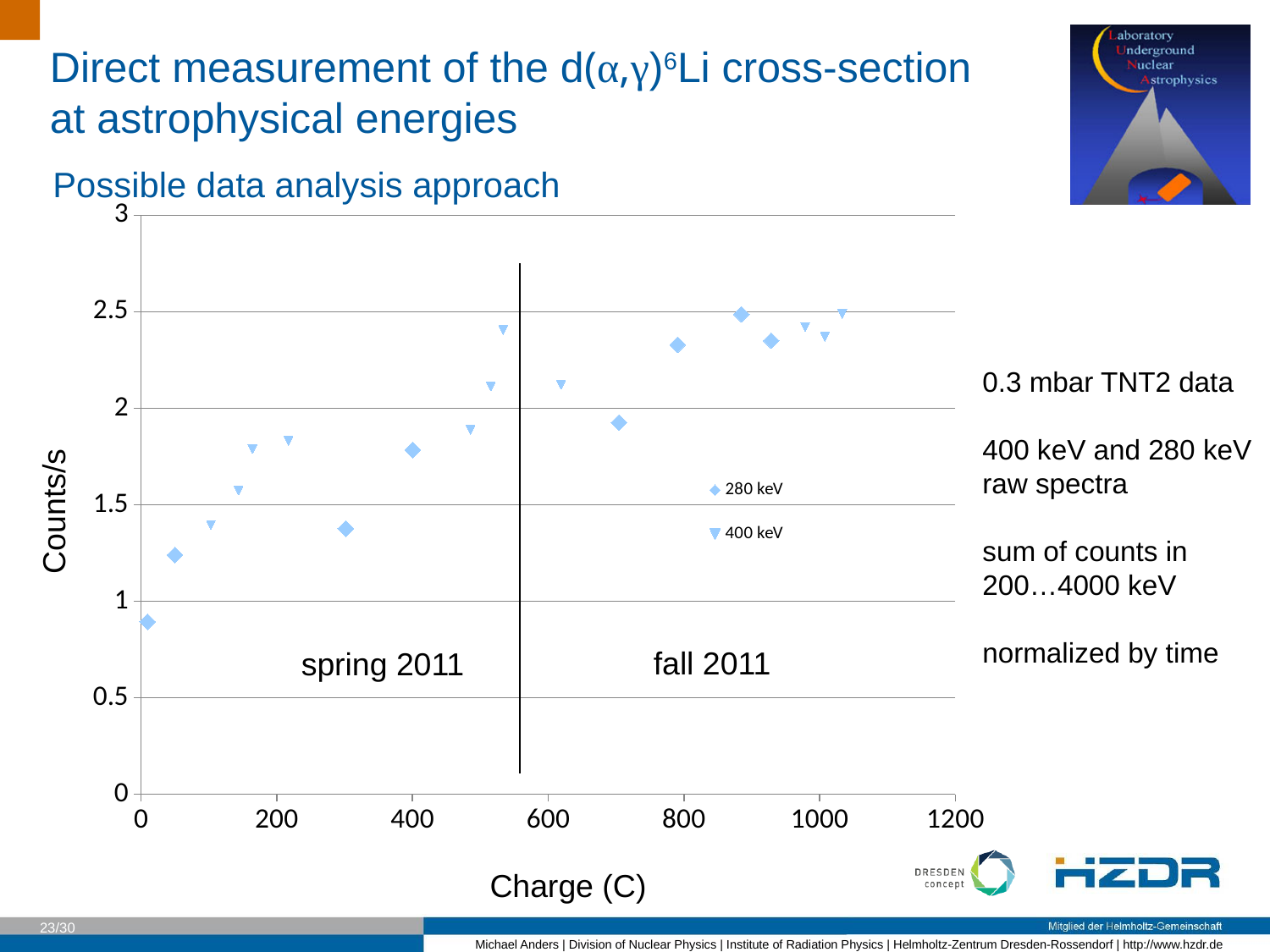
What is the label of the x axis of the chart? Charge (C) Which period label appears to the right of the vertical line in the chart, spring 2011 or fall 2011? fall 2011 Is the Counts/s value of the 400 keV point near 100 C greater or less than 1.5? less What kind of chart is shown on the slide? scatter chart Which series has the point with the lowest Counts/s value on the chart? 280 keV What are the two series named in the chart legend? 280 keV and 400 keV Is the Counts/s value of the 280 keV point near 300 C greater or less than 1.5? less Is the Counts/s value of the 280 keV point closest to 0 C greater or less than 1? less Do the Counts/s values generally rise or fall as Charge increases along the x axis? rise How many series does the chart legend list? 2